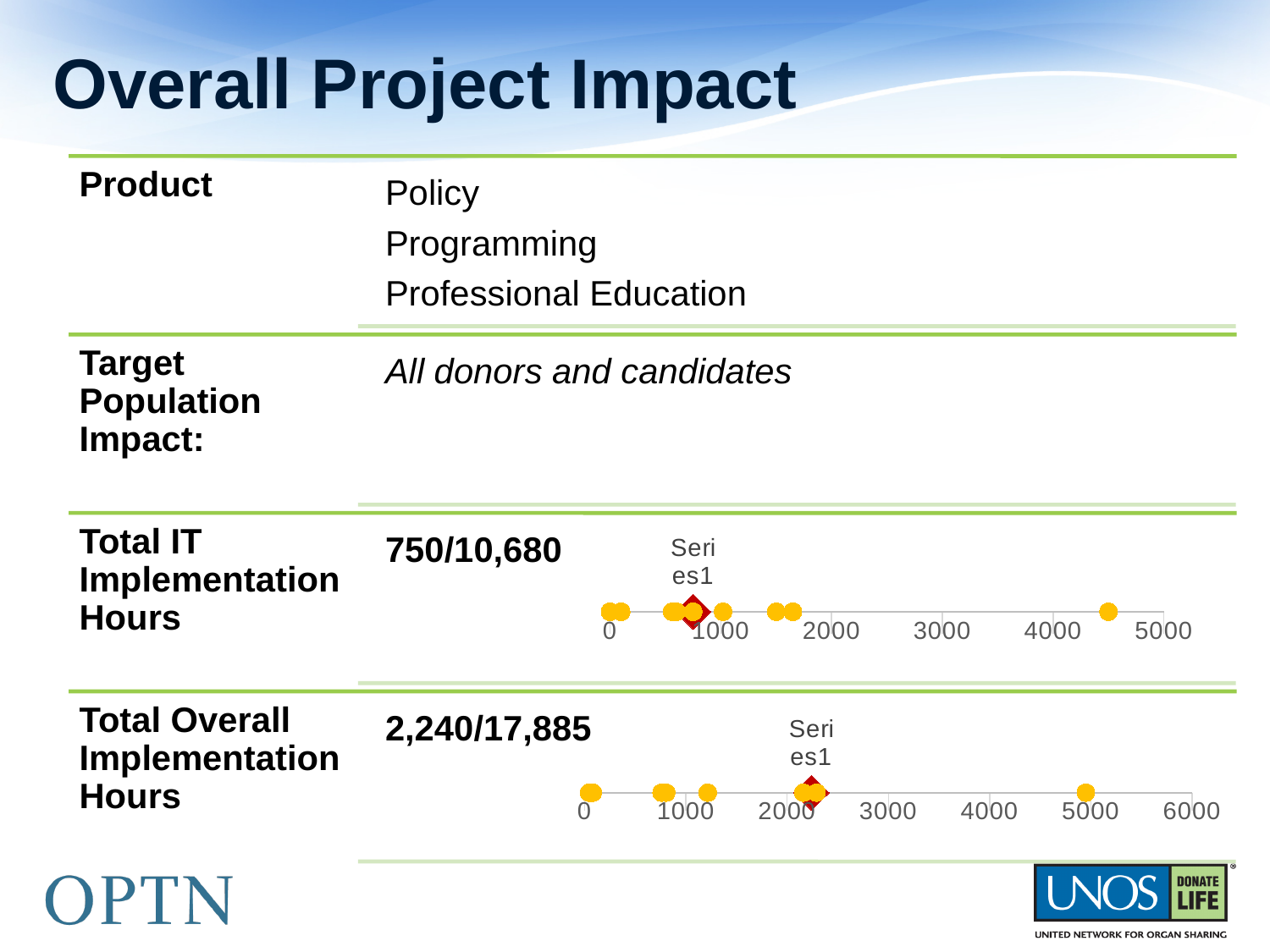
In the chart next to 'Total Overall Implementation Hours', is the red diamond marker greater or less than 2000? greater What kind of chart is shown next to 'Total IT Implementation Hours'? scatter (dot) chart In the chart next to 'Total IT Implementation Hours', how many series are labelled? 1 In the chart next to 'Total Overall Implementation Hours', is the red diamond marker greater or less than 3000? less In the chart next to 'Total IT Implementation Hours', is the red diamond marker greater or less than 1000? less In the chart next to 'Total IT Implementation Hours', what is the highest value labelled on the x axis? 5000 In the chart next to 'Total Overall Implementation Hours', what is the highest value labelled on the x axis? 6000 Which chart has the larger maximum value on its x axis, the one next to 'Total IT Implementation Hours' or the one next to 'Total Overall Implementation Hours'? Total Overall Implementation Hours